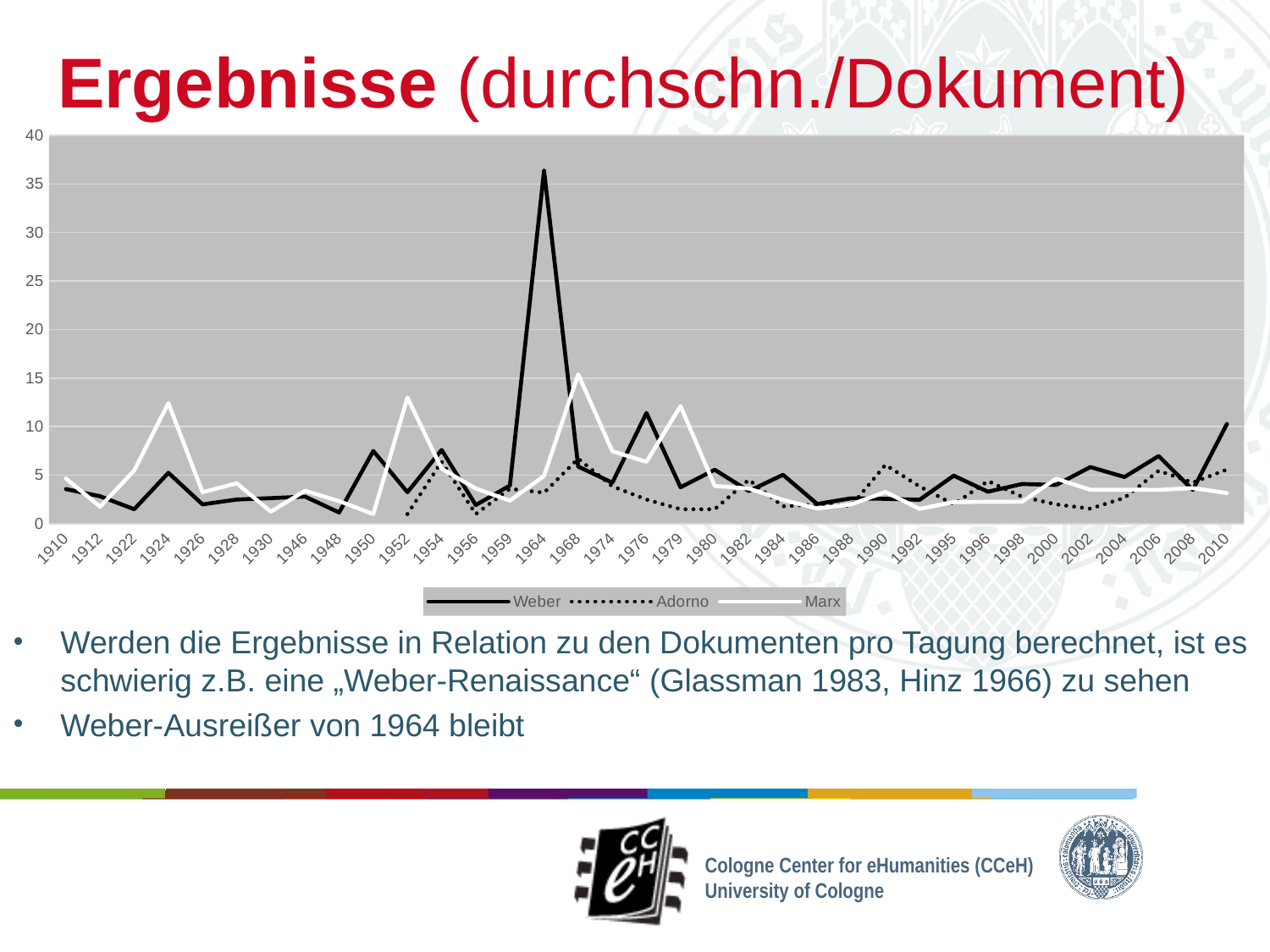
How many years are shown on the x axis of the chart? 35 Is the value for Marx in 1968 greater or less than 10? greater Which series reaches the highest value anywhere on the chart? Weber Is the value for Weber in 1964 greater or less than 30? greater In 1964, which series has the larger value, Weber or Adorno? Weber In which year does the Weber series reach its highest value? 1964 Which series are listed in the chart legend? Weber, Adorno, Marx Is the value for Adorno in 1952 greater or less than 5? less How many series does the chart legend list? 3 What kind of chart is shown on the slide? line chart Which series is drawn as a dotted line in the chart? Adorno